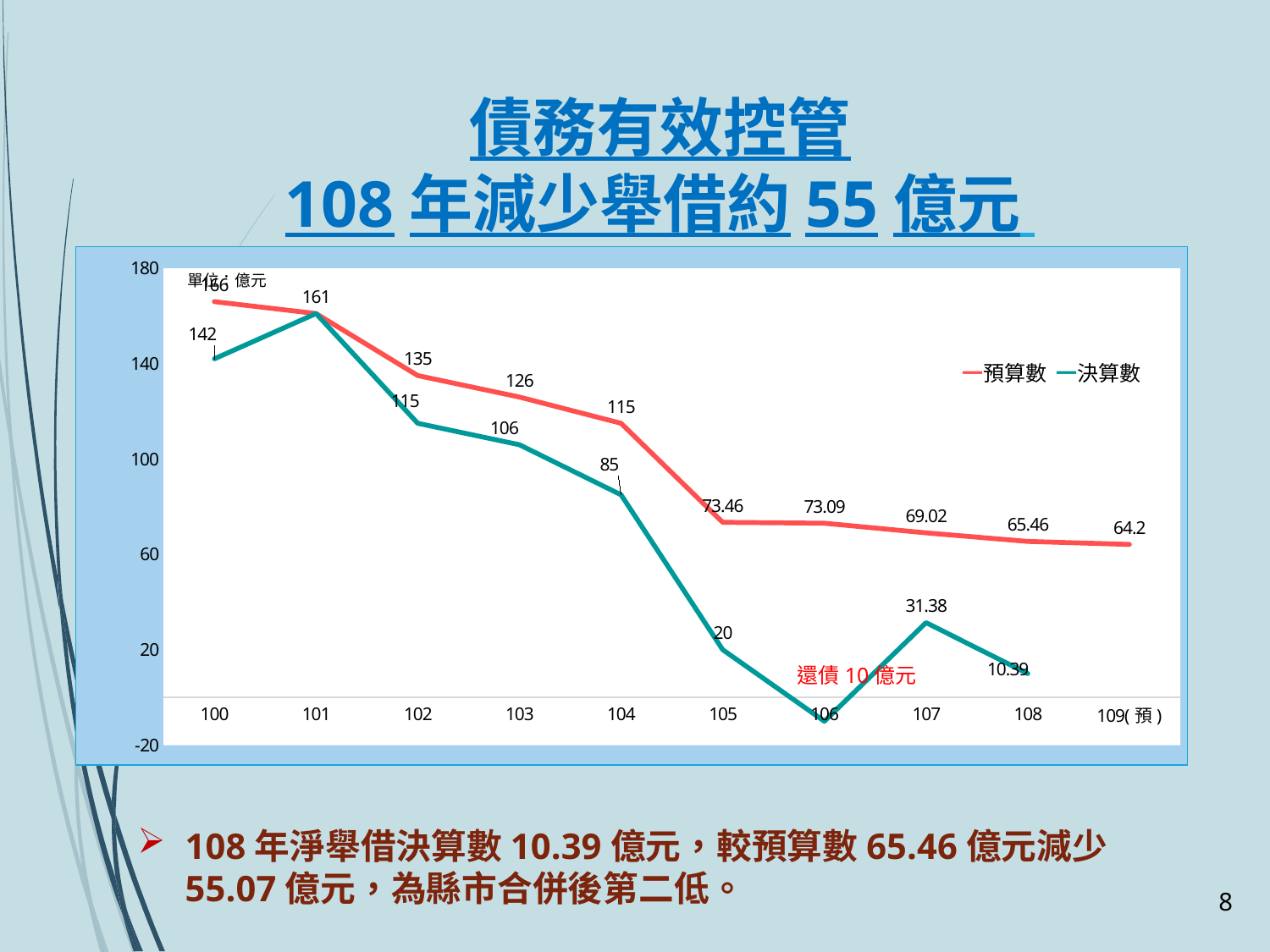
What is the 預算數 value for year 108? 65.46 In which year is the 決算數 value lowest? 106 What is the 預算數 value for year 105? 73.46 What is the difference between 預算數 and 決算數 in year 108? 55.07 What kind of chart is shown on the slide? line chart Does the 預算數 line generally rise or fall from year 100 to 109(預)? fall In year 104, which series has the larger value, 預算數 or 決算數? 預算數 What is the 決算數 value for year 107? 31.38 Is the 決算數 value for year 106 greater or less than 20? less What is the 決算數 value for year 108? 10.39 What is the 預算數 value for 109(預)? 64.2 How many series does the legend list? 2